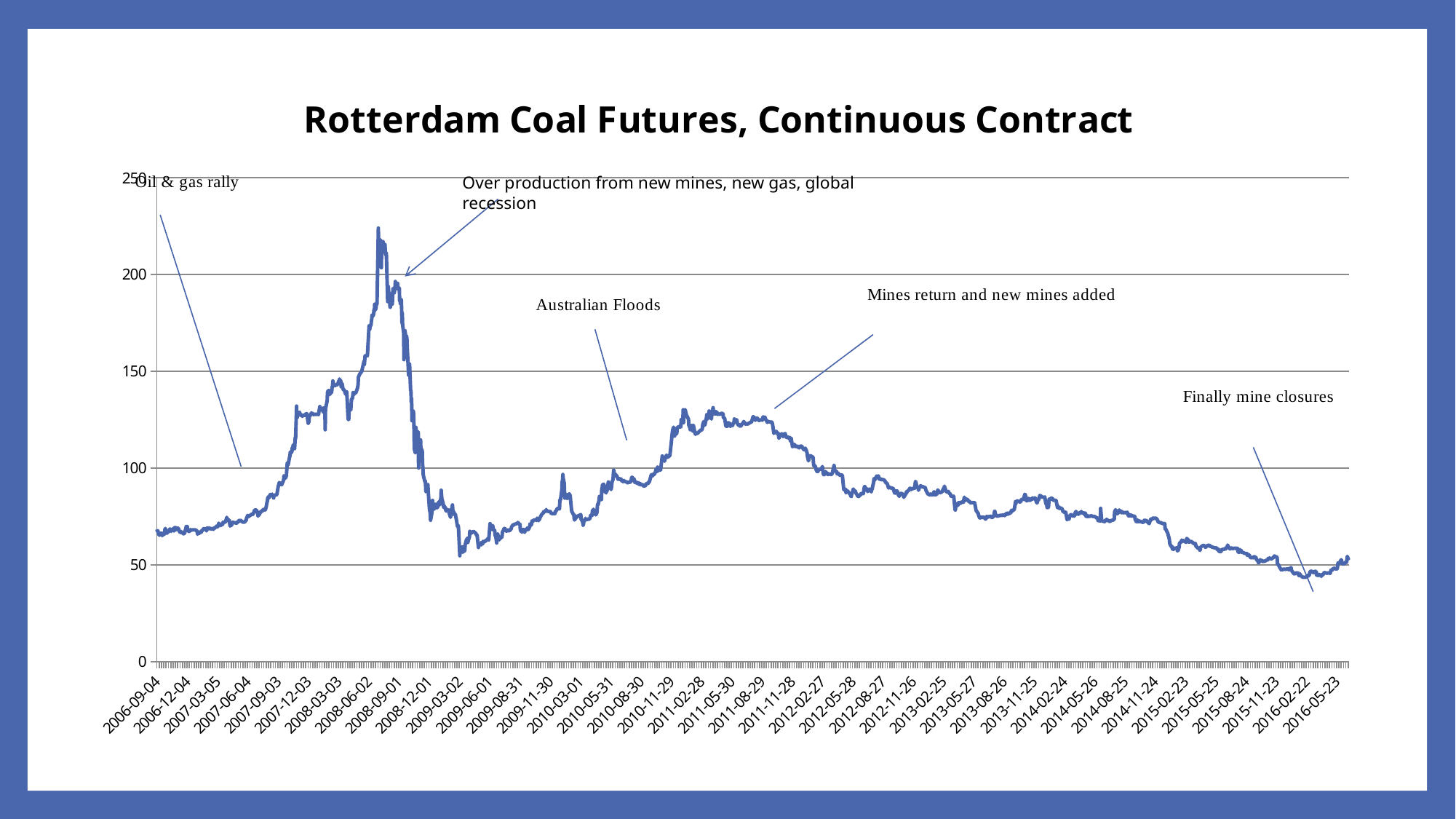
Do the values generally rise or fall between 2011-05-30 and 2016-02-22? fall In which year does the line reach its highest value? 2008 Is the value around 2011-05-30 greater or less than 100? greater Is the value around 2016-02-22 greater or less than 50? less Is the value at the start of the series (2006-09-04) greater or less than 100? less What is the title of the chart? Rotterdam Coal Futures, Continuous Contract What kind of chart is shown on the slide? line chart How many text annotations (event labels) are placed on the chart? 5 Which is larger: the value around 2008-09-01 or the value around 2011-05-30? 2008-09-01 In which year does the line reach its lowest value? 2016 Do the values generally rise or fall between 2006-09-04 and 2008-06-02? rise